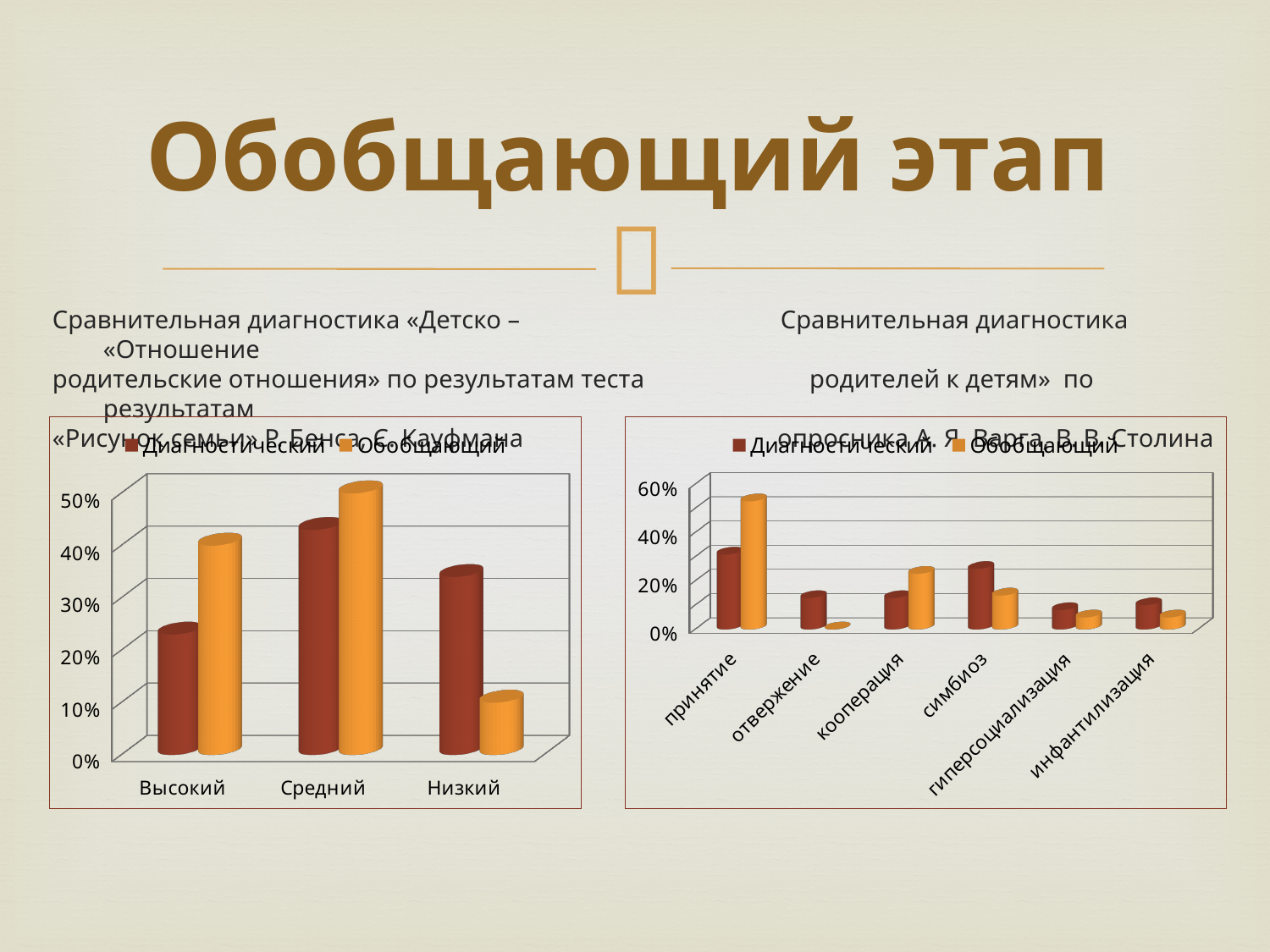
In the right chart, for the симбиоз category, which series has the larger value: Диагностический or Обобщающий? Диагностический In the left chart, which category has the highest value for the Обобщающий series? Средний In the left chart, is the Обобщающий value for Средний greater or less than 40%? greater In the left chart, for the Низкий category, which series has the larger value: Диагностический or Обобщающий? Диагностический In the left chart, which category has the lowest value for the Обобщающий series? Низкий What kind of chart is the left chart on the slide? bar chart How many series does the legend of the left chart list? 2 In the right chart, which category has the lowest value for the Обобщающий series? отвержение How many categories does the left chart show? 3 How many categories does the right chart show? 6 In the right chart, is the Обобщающий value for принятие greater or less than 40%? greater In the left chart, is the Обобщающий value for Низкий greater or less than 20%? less